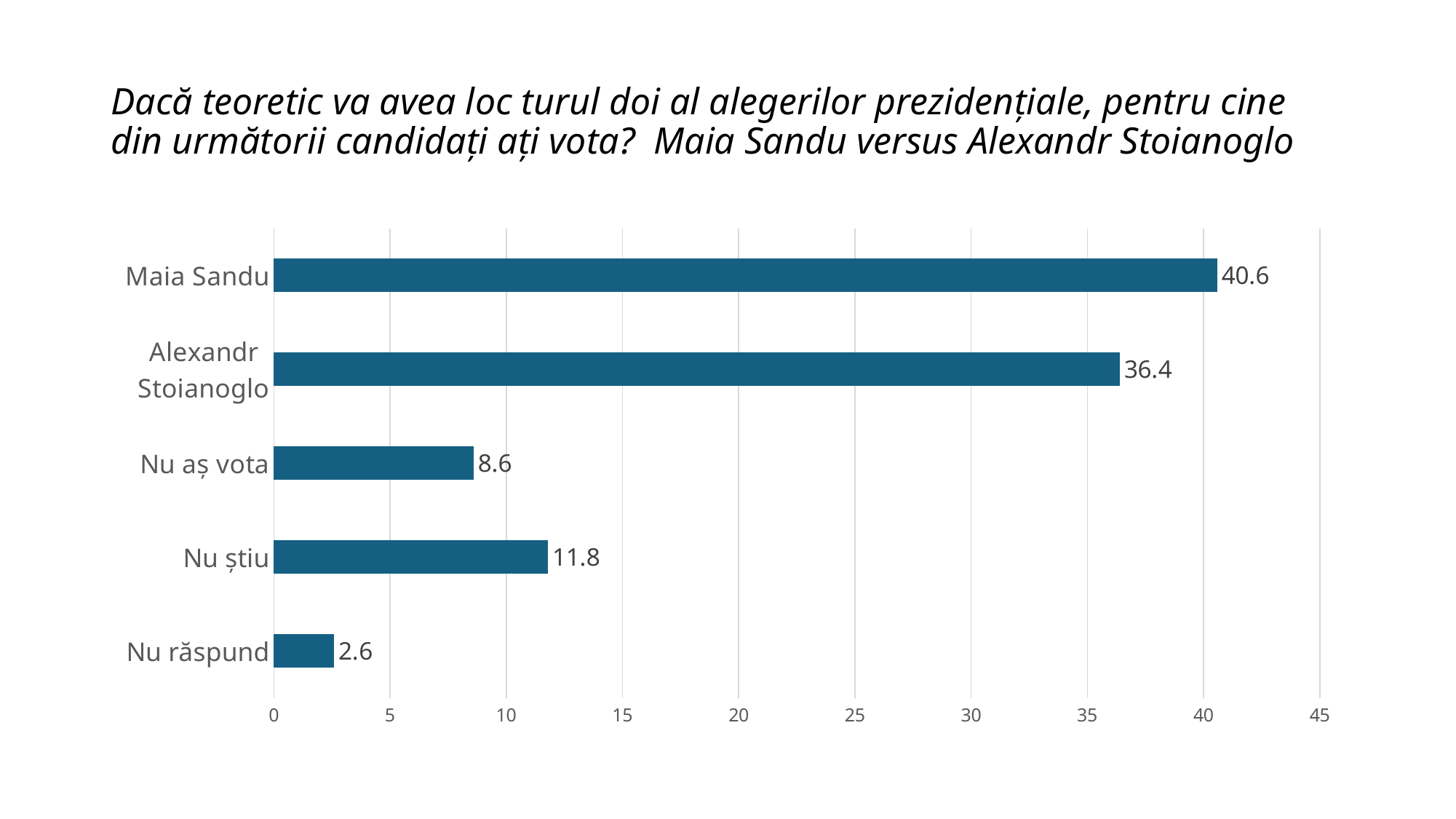
What is the value for Nu răspund? 2.6 Which is larger, the value for Nu aș vota or the value for Nu știu? Nu știu Which category has the highest value? Maia Sandu Which category has the lowest value? Nu răspund What is the value for Nu știu? 11.8 What is the difference between the values for Maia Sandu and Alexandr Stoianoglo? 4.2 What is the value for Alexandr Stoianoglo? 36.4 What is the highest value shown on the x axis? 45 How many categories are shown in the chart? 5 What is the value for Maia Sandu? 40.6 What kind of chart is shown on the slide? Bar chart Is the value for Alexandr Stoianoglo greater or less than 35? greater